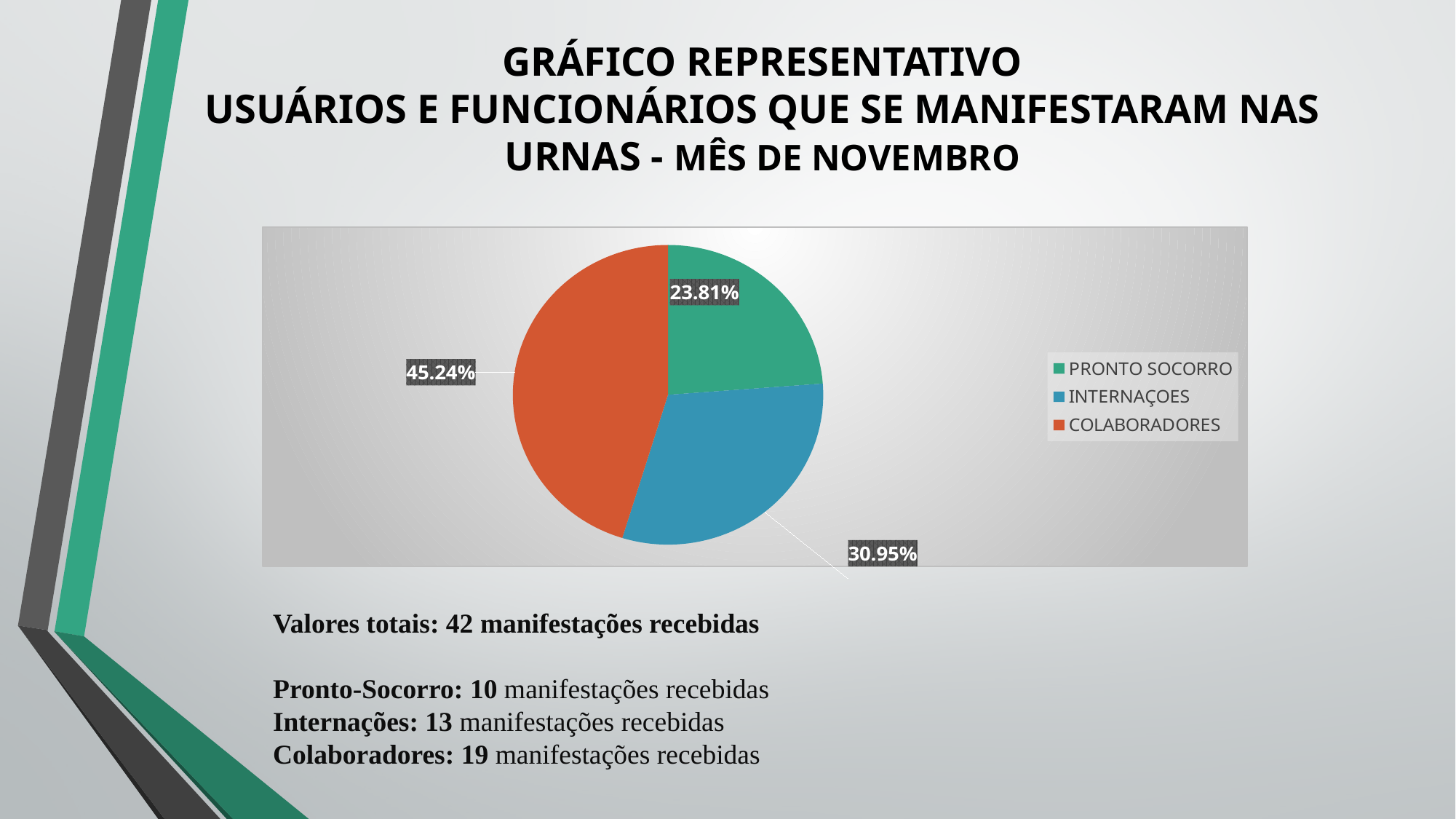
What share of the pie does PRONTO SOCORRO represent? 23.81% How many slices does the pie chart have? 3 Which slice is larger, INTERNAÇOES or PRONTO SOCORRO? INTERNAÇOES What is the difference in percentage points between the COLABORADORES slice and the PRONTO SOCORRO slice? 21.43 What share of the pie does INTERNAÇOES represent? 30.95% What share of the pie does COLABORADORES represent? 45.24% How many entries does the legend list? 3 Which category has the largest slice of the pie? COLABORADORES What is the difference in percentage points between the INTERNAÇOES slice and the PRONTO SOCORRO slice? 7.14 What kind of chart is shown on the slide? pie chart Which category has the smallest slice of the pie? PRONTO SOCORRO What colour is the COLABORADORES slice in the pie chart? orange